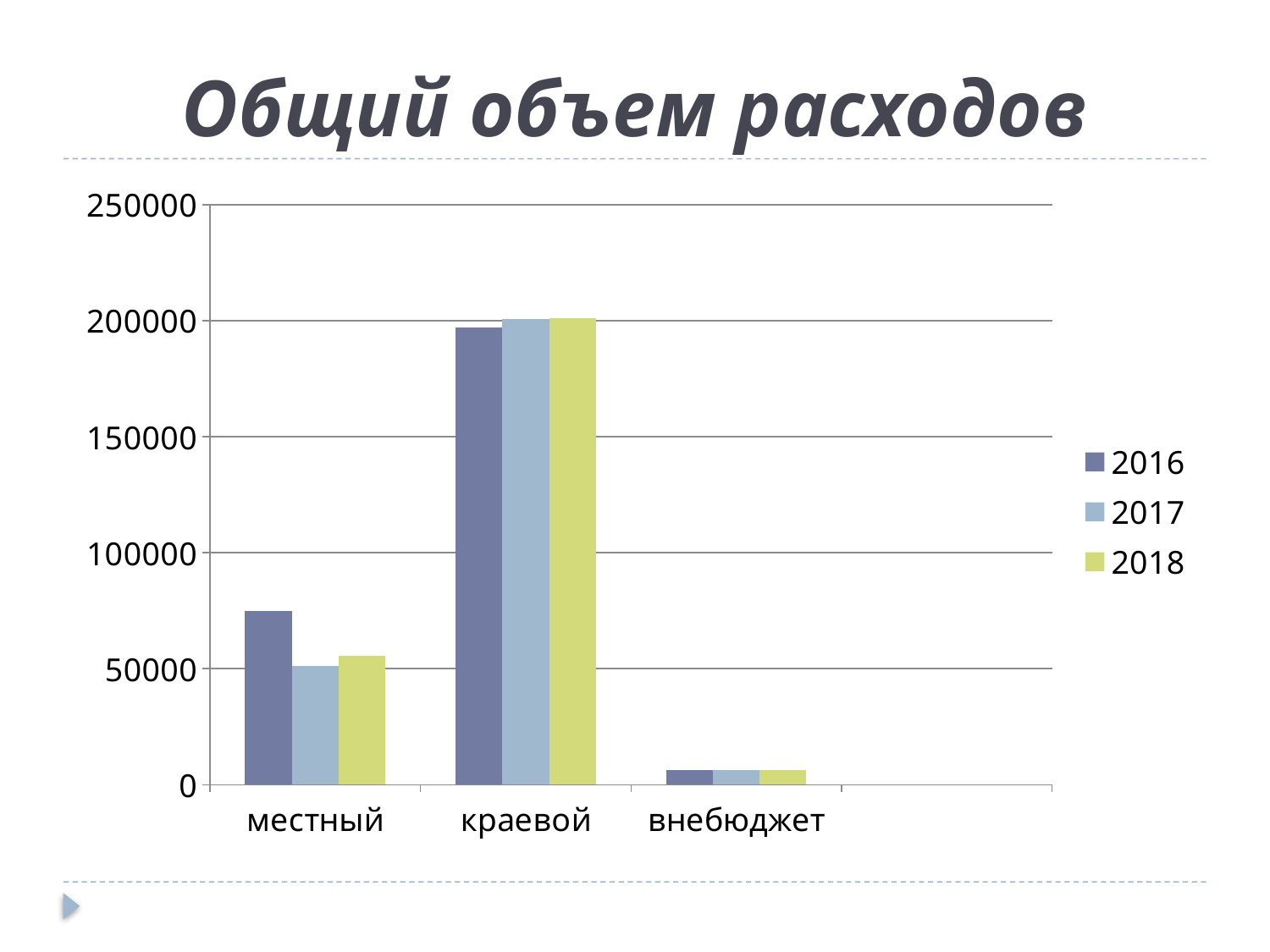
Is the value for местный in 2016 greater or less than 100000? less Which category has the lowest values across all years? внебюджет How many categories are shown on the x axis? 3 How many series does the legend list? 3 Which category has the highest values across all years? краевой Is the value for краевой in 2016 greater or less than 150000? greater What kind of chart is shown on the slide? bar chart For местный, which is larger: the value for 2016 or the value for 2017? 2016 Is the value for внебюджет in 2018 greater or less than 50000? less What is the title of the chart? Общий объем расходов Which years are listed in the legend? 2016, 2017, 2018